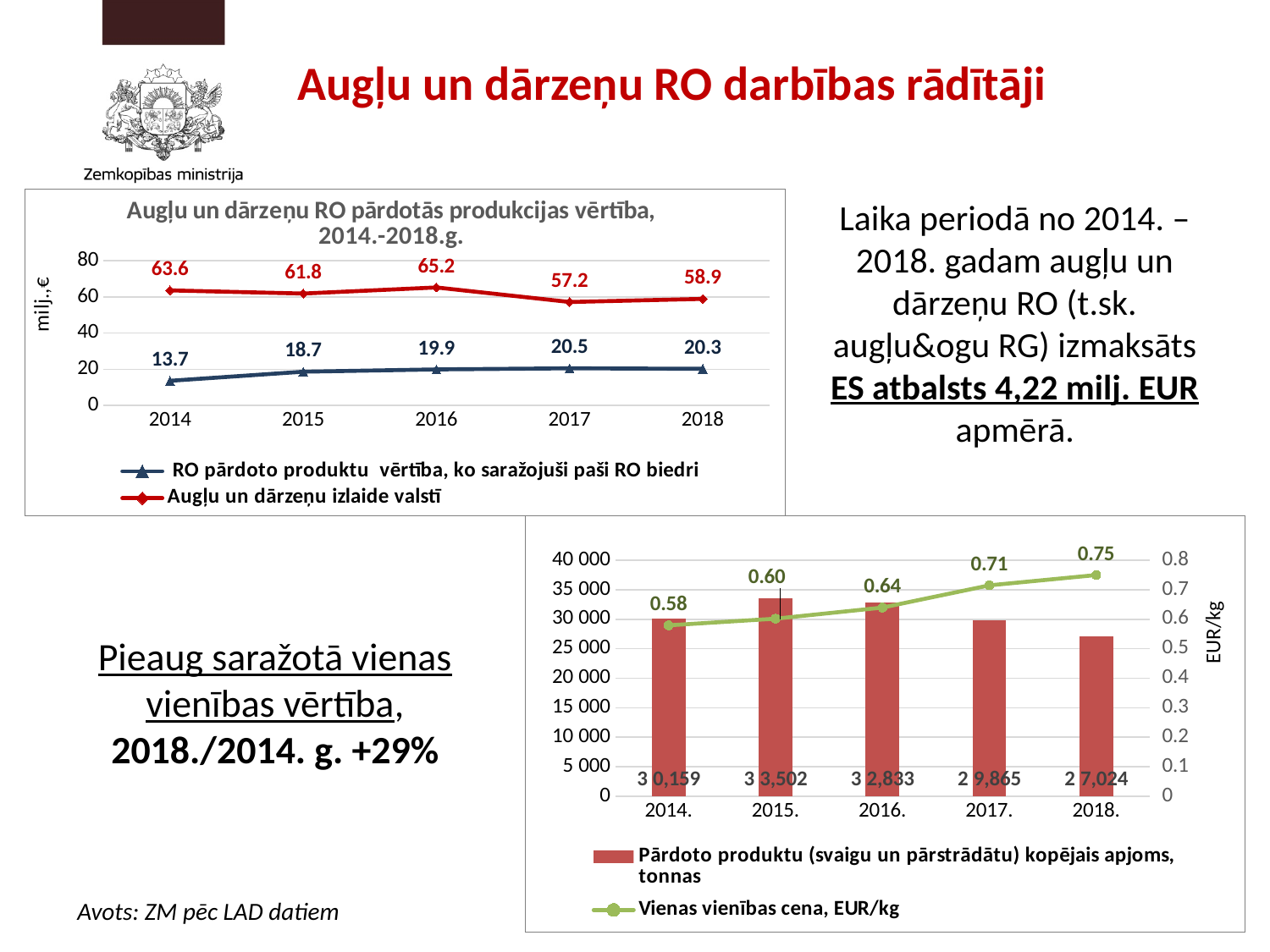
In the top chart, what is the difference between 'Augļu un dārzeņu izlaide valstī' and 'RO pārdoto produktu vērtība, ko saražojuši paši RO biedri' in 2018? 38.6 In the top chart 'Augļu un dārzeņu RO pārdotās produkcijas vērtība, 2014.-2018.g.', what is the value of 'Augļu un dārzeņu izlaide valstī' in 2016? 65.2 In the top chart, how many series does the legend list? 2 What type of chart is the top chart? Line chart In the bottom chart, does 'Vienas vienības cena, EUR/kg' rise or fall from 2014 to 2018? Rise In the bottom chart, in which year is 'Pārdoto produktu (svaigu un pārstrādātu) kopējais apjoms, tonnas' lowest? 2018. In the top chart, what is the value of 'RO pārdoto produktu vērtība, ko saražojuši paši RO biedri' in 2014? 13.7 In the bottom chart, what is the value of 'Vienas vienības cena, EUR/kg' in 2017? 0.71 In the bottom chart, how many years are shown on the x axis? 5 In the bottom chart, in which year is 'Pārdoto produktu (svaigu un pārstrādātu) kopējais apjoms, tonnas' highest? 2015. In the top chart, in which year is 'Augļu un dārzeņu izlaide valstī' lowest? 2017 In the top chart, in which year is 'RO pārdoto produktu vērtība, ko saražojuši paši RO biedri' highest? 2017